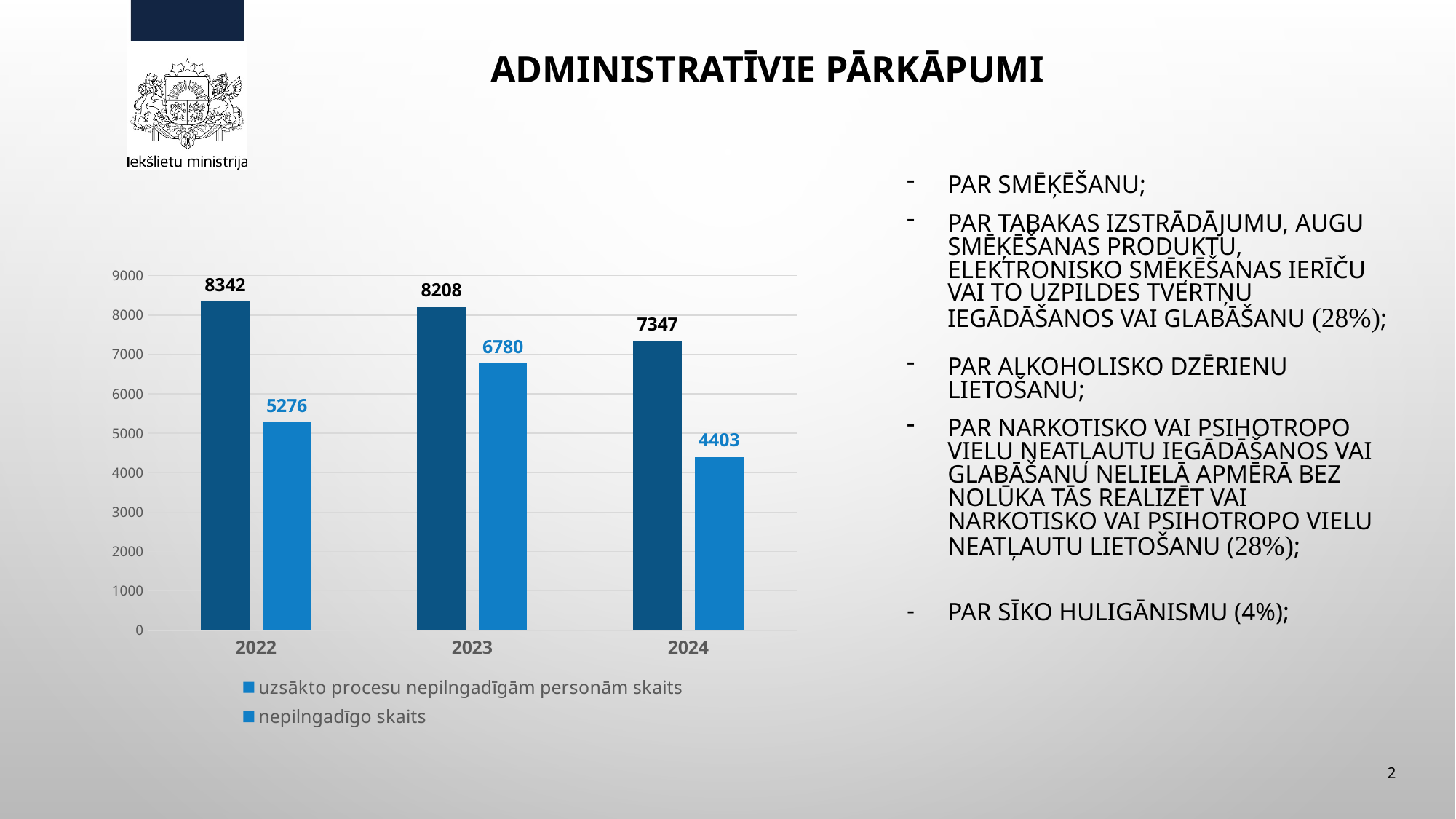
Is the value for 'uzsākto procesu nepilngadīgām personām skaits' in 2024 greater or less than 7000? greater What kind of chart is shown on the slide? bar chart What is the difference between 'uzsākto procesu nepilngadīgām personām skaits' and 'nepilngadīgo skaits' in 2022? 3066 How many series does the chart legend list? 2 What is the value of 'nepilngadīgo skaits' for 2023? 6780 What is the value of 'uzsākto procesu nepilngadīgām personām skaits' for 2022? 8342 What is the difference in 'uzsākto procesu nepilngadīgām personām skaits' between 2023 and 2024? 861 How many years are shown on the x axis of the chart? 3 In which year is 'nepilngadīgo skaits' the lowest? 2024 What is the value of 'nepilngadīgo skaits' for 2024? 4403 Which is larger: 'nepilngadīgo skaits' in 2022 or in 2023? 2023 In which year is 'uzsākto procesu nepilngadīgām personām skaits' the highest? 2022